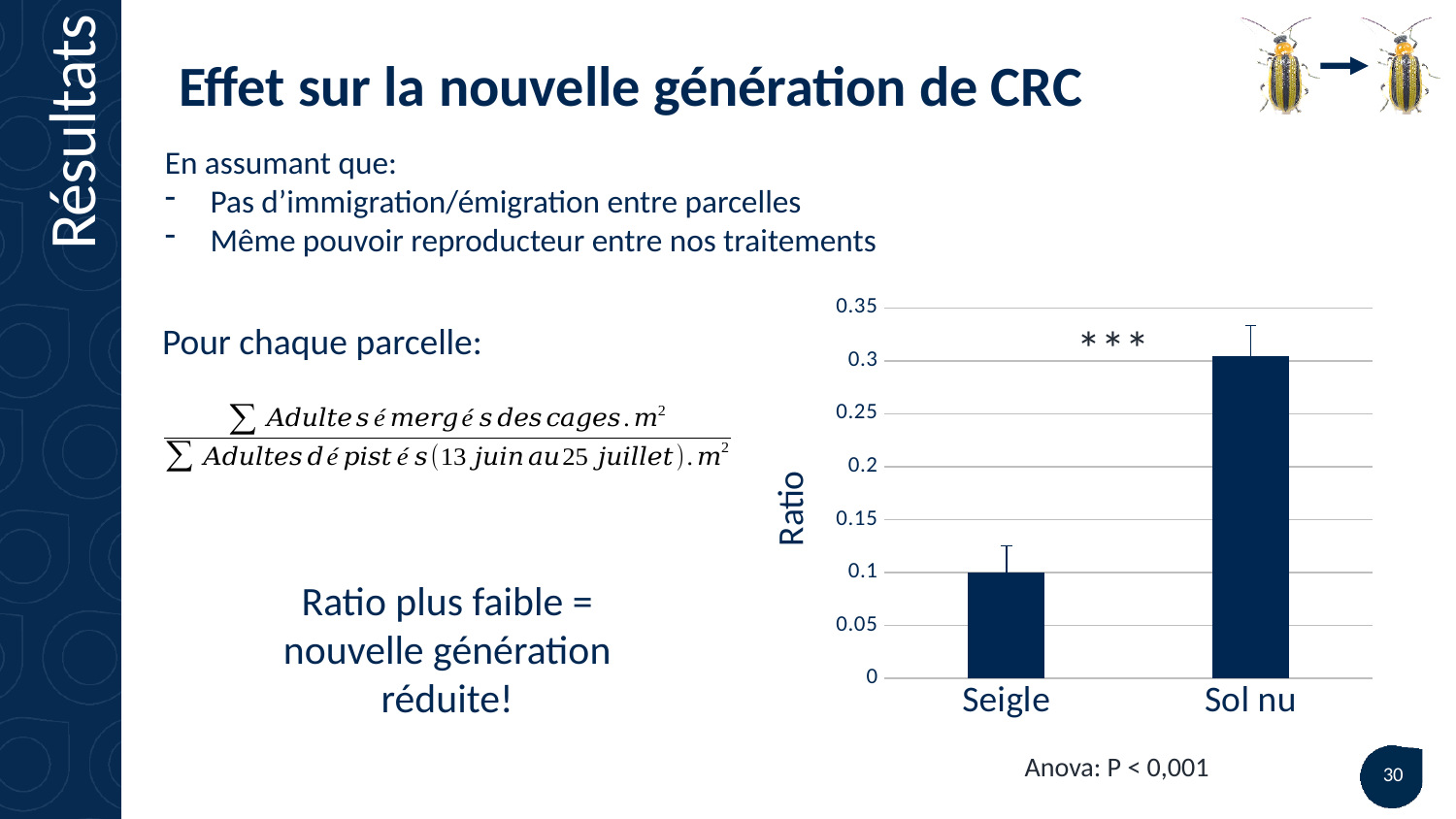
Is the ratio for Seigle greater or less than 0.05? greater Is the ratio for Sol nu greater or less than 0.35? less What is the label of the y axis of the chart? Ratio What is the highest tick value shown on the y axis of the chart? 0.35 How many categories are shown on the x axis of the chart? 2 Which has a larger ratio, Seigle or Sol nu? Sol nu What kind of chart is shown on the slide? bar chart Which category has the lowest ratio in the chart? Seigle Which category has the highest ratio in the chart? Sol nu Do the bar values rise or fall from Seigle to Sol nu? rise Is the ratio for Sol nu greater or less than 0.25? greater